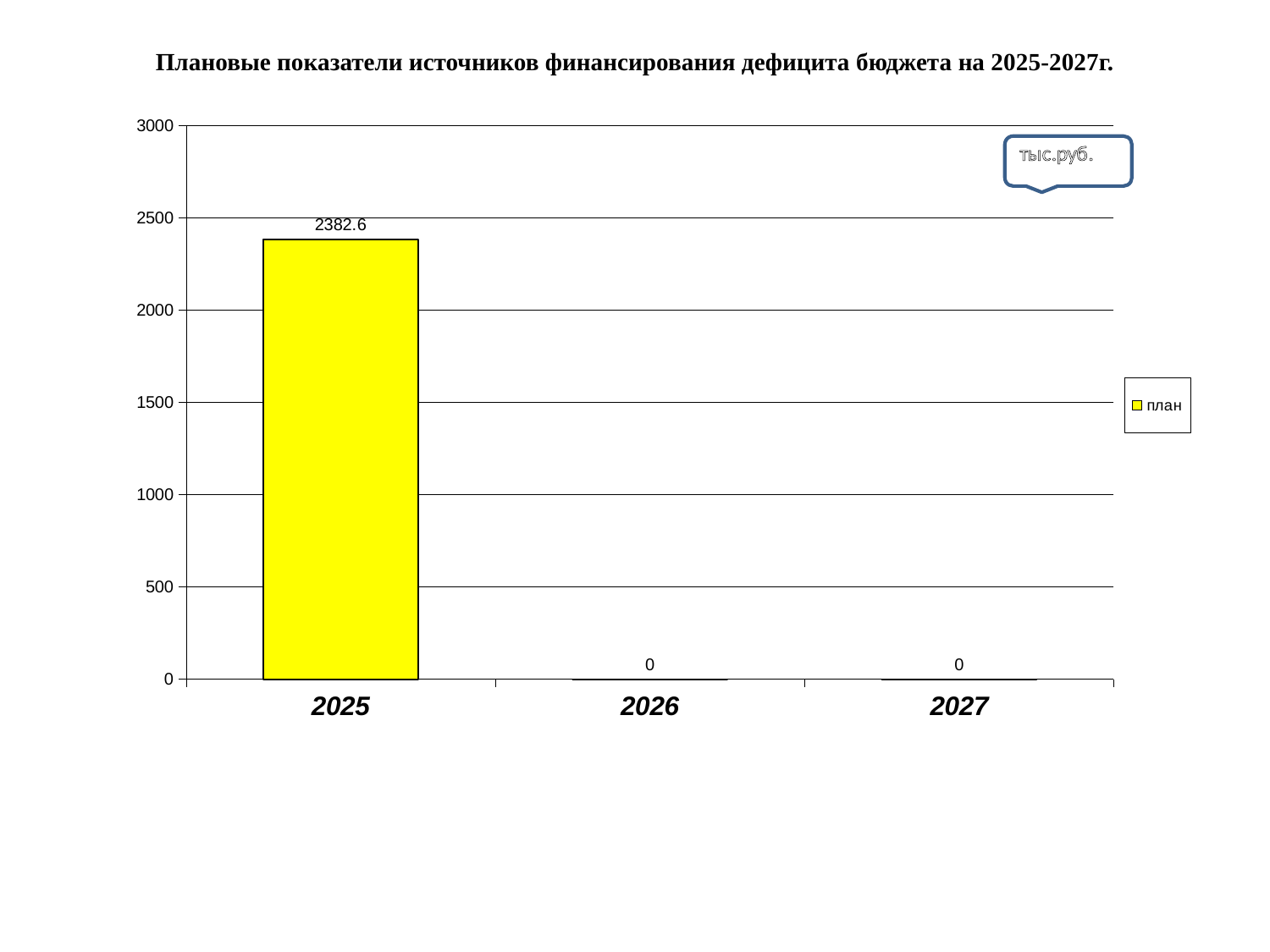
What kind of chart is shown? bar chart Is the value for 2025 greater or less than 2500? less How many series does the legend list? 1 Which is larger, the value for 2025 or the value for 2027? 2025 What is the difference between the values for 2025 and 2026? 2382.6 How many years are shown on the x axis? 3 Is the value for 2025 greater or less than 2000? greater What is the value for 2027? 0 Which year has the highest value? 2025 What is the name of the series in the legend? план What is the value for 2025? 2382.6 What is the value for 2026? 0